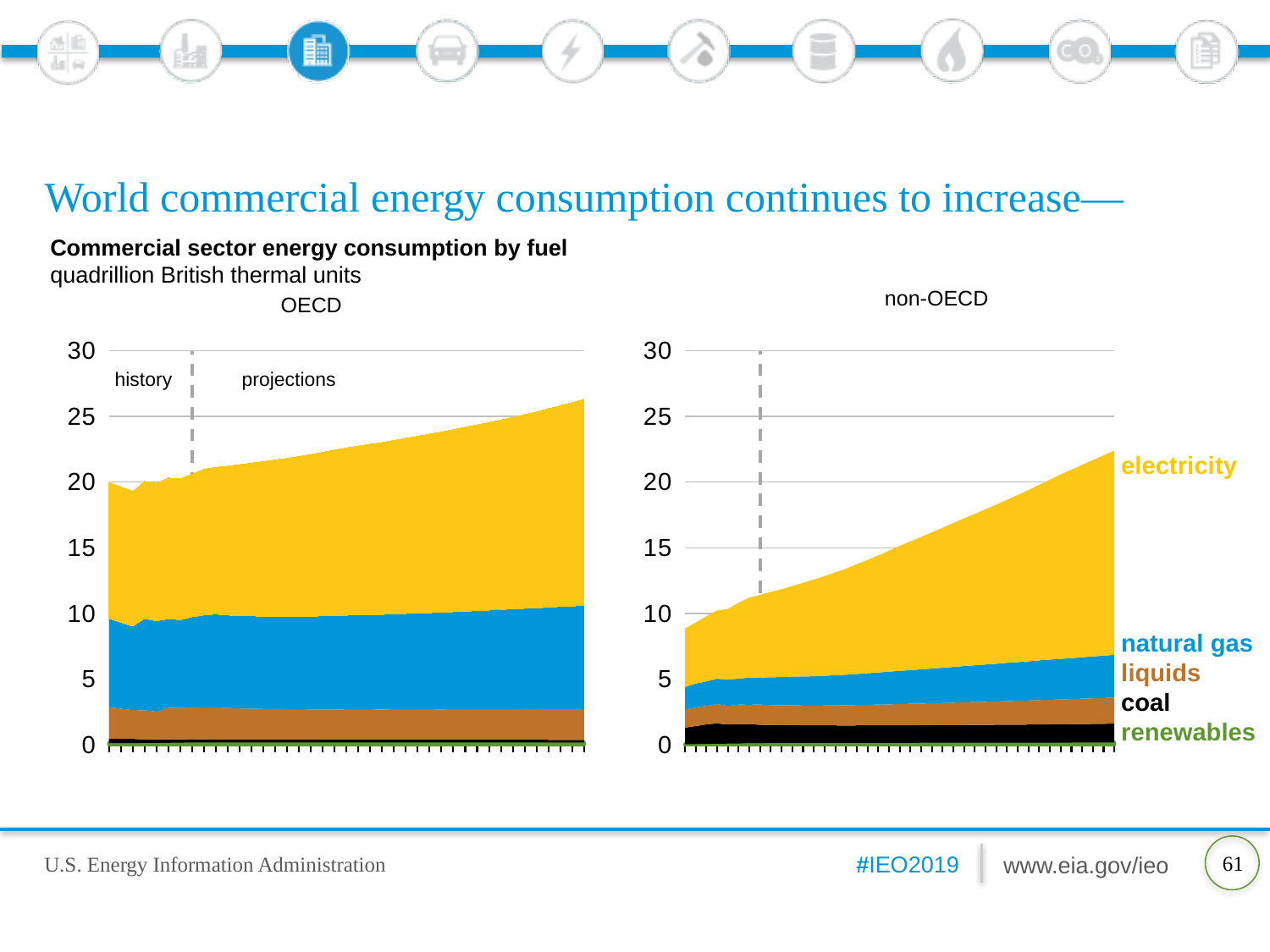
What kind of chart is the OECD chart? stacked area chart In the OECD chart, is total consumption at the start of the history period greater or less than 15? greater In the OECD chart, which fuel accounts for the largest share of consumption? electricity How many fuel series does the legend list? 5 In the non-OECD chart, does total consumption rise or fall over the projection period? rise In the non-OECD chart, which fuel accounts for the smallest share of consumption? renewables In the OECD chart, does total consumption rise or fall over the projection period? rise What unit is used for the values on both charts? quadrillion British thermal units At the end of the projection period, which chart shows higher total consumption, OECD or non-OECD? OECD In the non-OECD chart, is total consumption at the end of the projection period greater or less than 25? less What is the title of the chart pair? Commercial sector energy consumption by fuel In the non-OECD chart, is total consumption at the end of the projection period greater or less than 20? greater